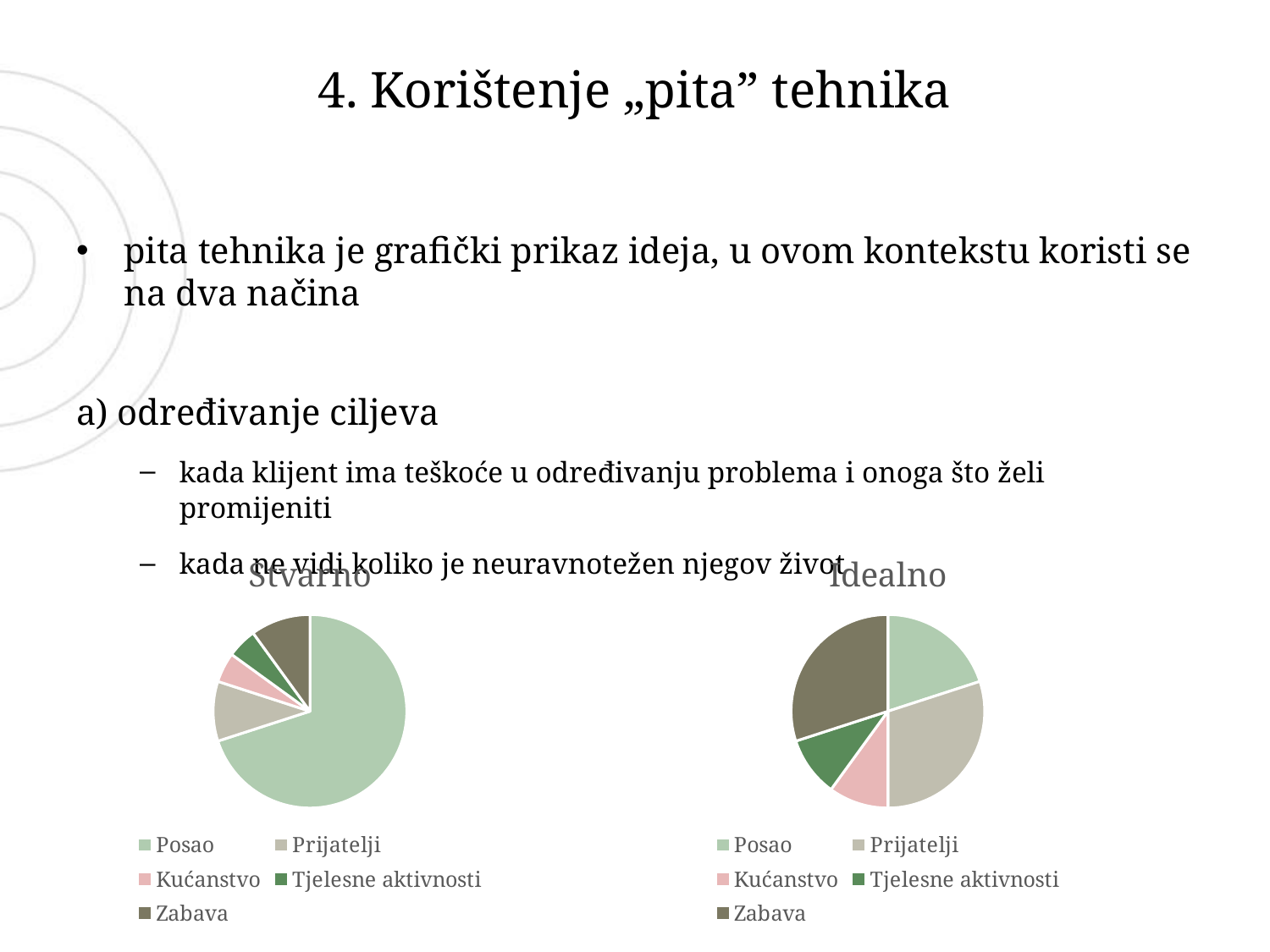
In the "Idealno" chart, which slice is larger, Zabava or Kućanstvo? Zabava In the "Idealno" chart, which category is shown in pink? Kućanstvo In the "Stvarno" chart, which category has the largest slice? Posao In the "Stvarno" chart, which slice is larger, Posao or Prijatelji? Posao In the "Idealno" chart, which slice is larger, Prijatelji or Posao? Prijatelji How many categories does the legend of the "Stvarno" chart list? 5 How many categories does the legend of the "Idealno" chart list? 5 What are the titles of the two pie charts on the slide? Stvarno and Idealno What kind of chart is the "Idealno" chart on the right? pie chart What kind of chart is the "Stvarno" chart on the left? pie chart